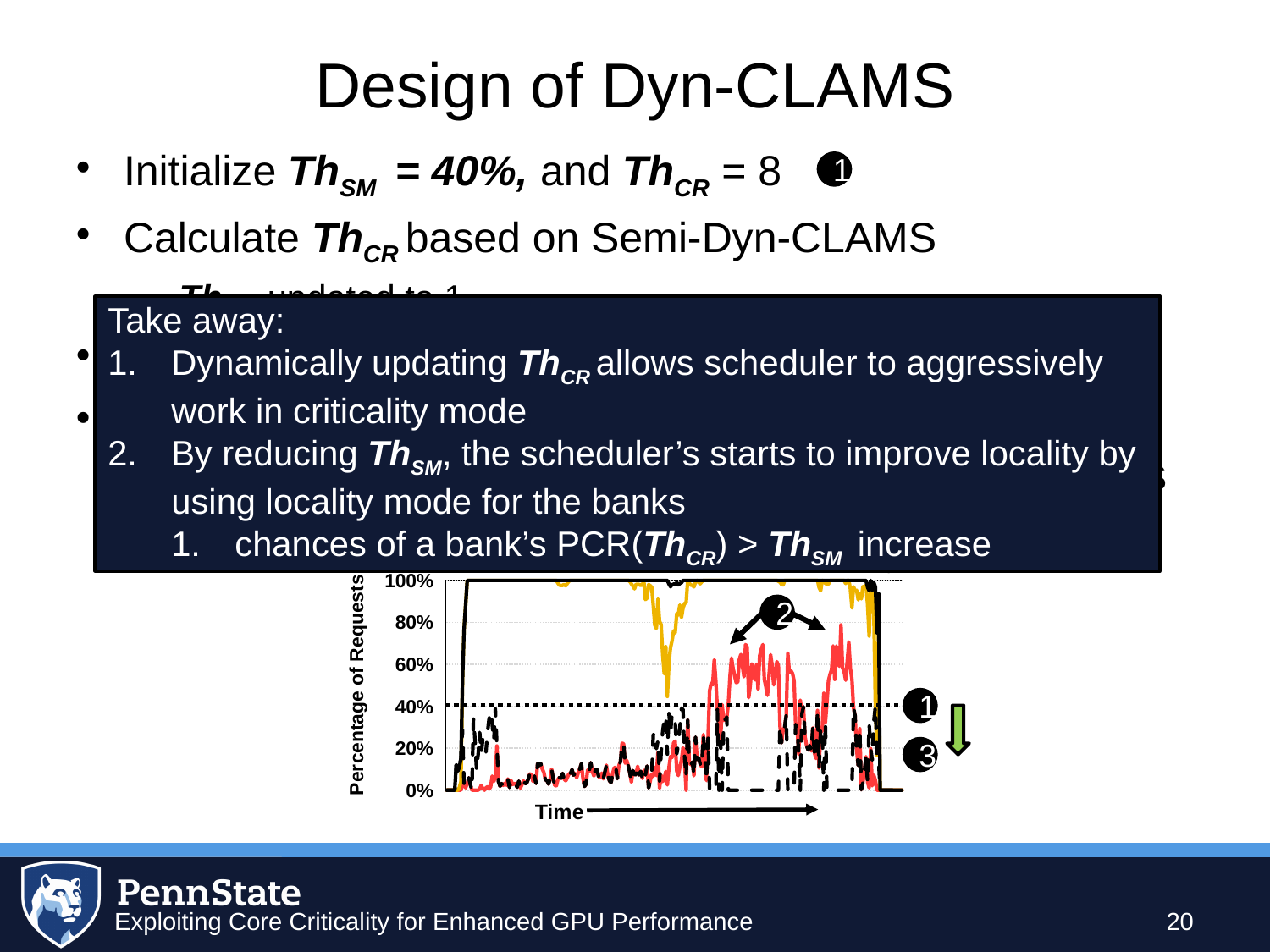
What is the highest tick value shown on the vertical axis of the chart? 100% Is the peak value of the red line greater or less than 100%? less How many tick labels are shown on the vertical axis of the chart? 6 At what percentage is the horizontal dotted threshold line drawn on the chart? 40% What is the label of the horizontal axis of the chart? Time Which line reaches a higher peak on the chart, the yellow line or the red line? the yellow line What is the label of the vertical axis of the chart? Percentage of Requests Is the lowest value of the red line greater or less than 20%? less What is the lowest tick value shown on the vertical axis of the chart? 0% Is the peak value of the red line greater or less than 60%? greater What is the spacing between consecutive tick labels on the vertical axis? 20% What kind of chart is shown at the bottom of the slide? line chart